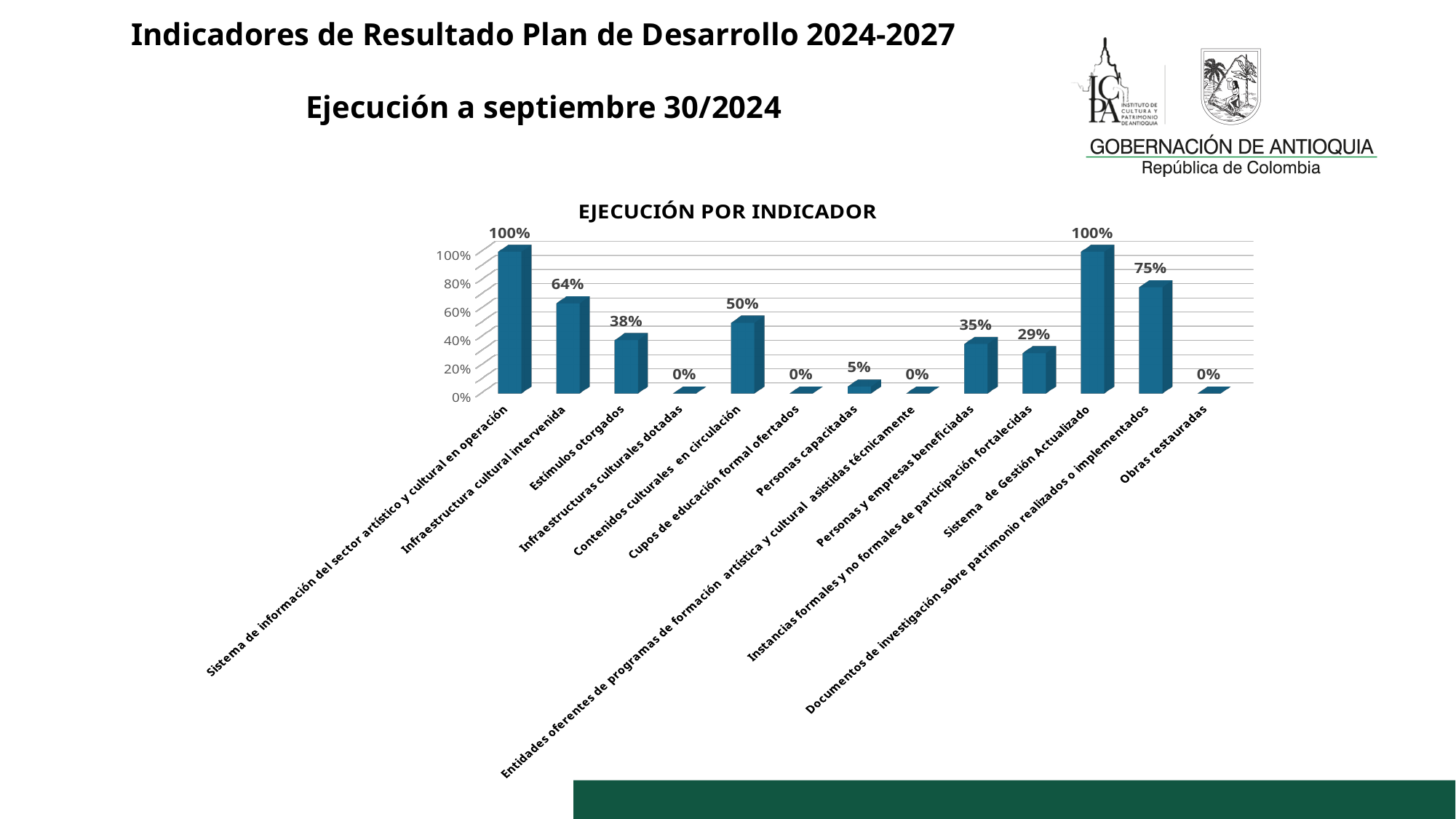
What is the difference between Personas y empresas beneficiadas and Instancias formales y no formales de participación fortalecidas? 6% What is the value for Documentos de investigación sobre patrimonio realizados o implementados? 75% How many indicators are shown on the x axis? 13 Which is larger, Estímulos otorgados or Contenidos culturales en circulación? Contenidos culturales en circulación What is the value for Obras restauradas? 0% What is the value for Estímulos otorgados? 38% How many indicators have a value of 0%? 4 Which two indicators reach 100%? Sistema de información del sector artístico y cultural en operación and Sistema de Gestión Actualizado What is the value for Contenidos culturales en circulación? 50% What is the value for Personas capacitadas? 5% What is the title of the chart? EJECUCIÓN POR INDICADOR What is the value for Infraestructura cultural intervenida? 64%